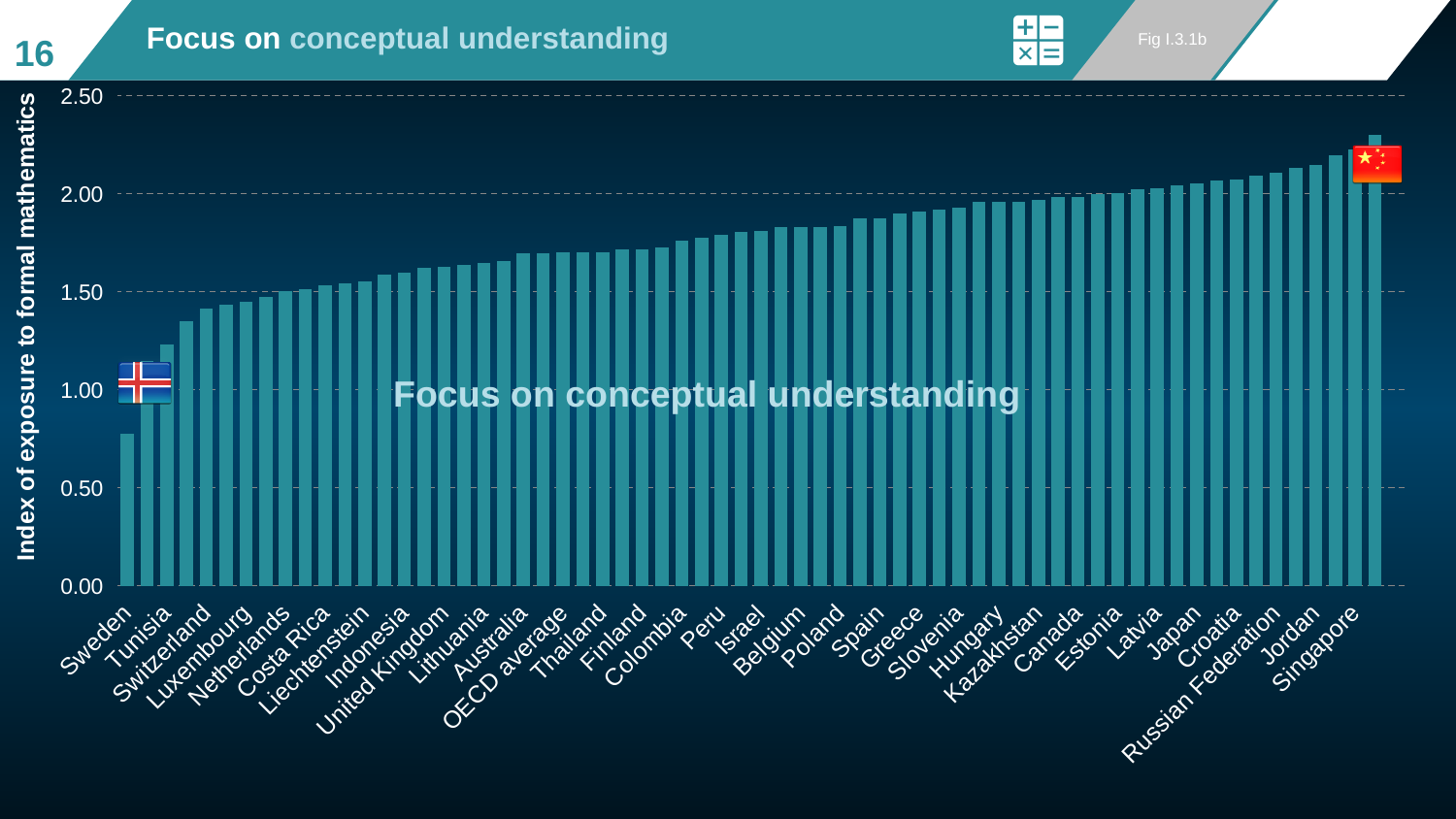
What is the label of the vertical axis? Index of exposure to formal mathematics Is the value for Switzerland greater or less than 1.50? less What kind of chart is shown on the slide? bar chart Is the value for Singapore greater or less than 2.00? greater Do the bar values rise or fall from left to right along the x axis? rise Is the value for Spain greater or less than 2.00? less Which has the larger value, Sweden or Singapore? Singapore Which labelled country has the lowest value in the chart? Sweden What is the title of the chart? Focus on conceptual understanding